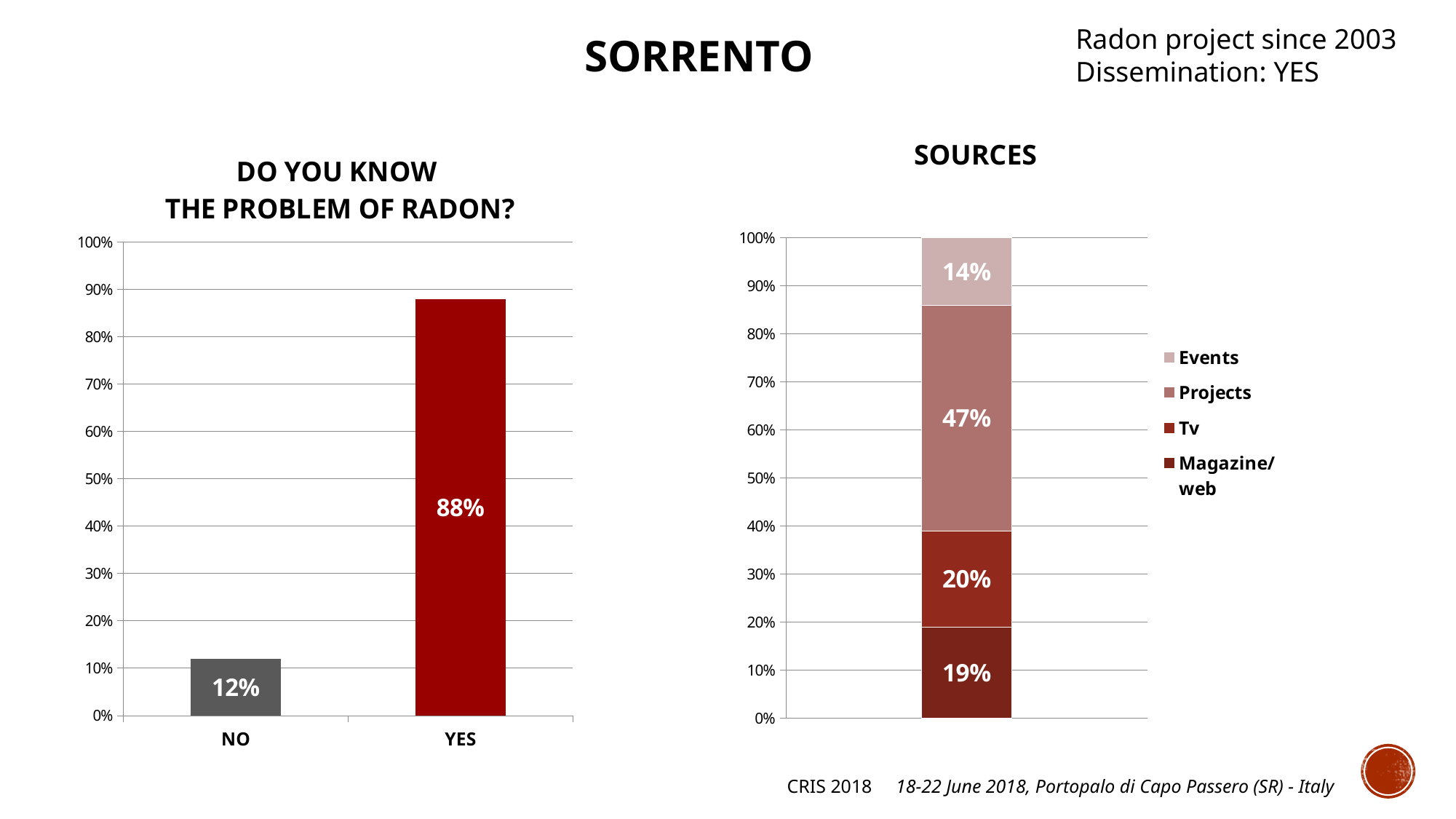
In the 'DO YOU KNOW THE PROBLEM OF RADON?' chart, what is the value for NO? 12% In the 'SOURCES' chart, how many series does the legend list? 4 In the 'SOURCES' chart, what is the value for Events? 14% What kind of chart is the 'SOURCES' chart? Stacked bar chart In the 'DO YOU KNOW THE PROBLEM OF RADON?' chart, how many categories are shown? 2 In the 'DO YOU KNOW THE PROBLEM OF RADON?' chart, which category has the higher value? YES In the 'SOURCES' chart, what is the value for Projects? 47% In the 'SOURCES' chart, which is larger, Tv or Magazine/web? Tv In the 'SOURCES' chart, what is the total of the stacked bar? 100% In the 'SOURCES' chart, which source has the largest share? Projects In the 'DO YOU KNOW THE PROBLEM OF RADON?' chart, what is the value for YES? 88% In the 'DO YOU KNOW THE PROBLEM OF RADON?' chart, what is the difference between the YES and NO values? 76%